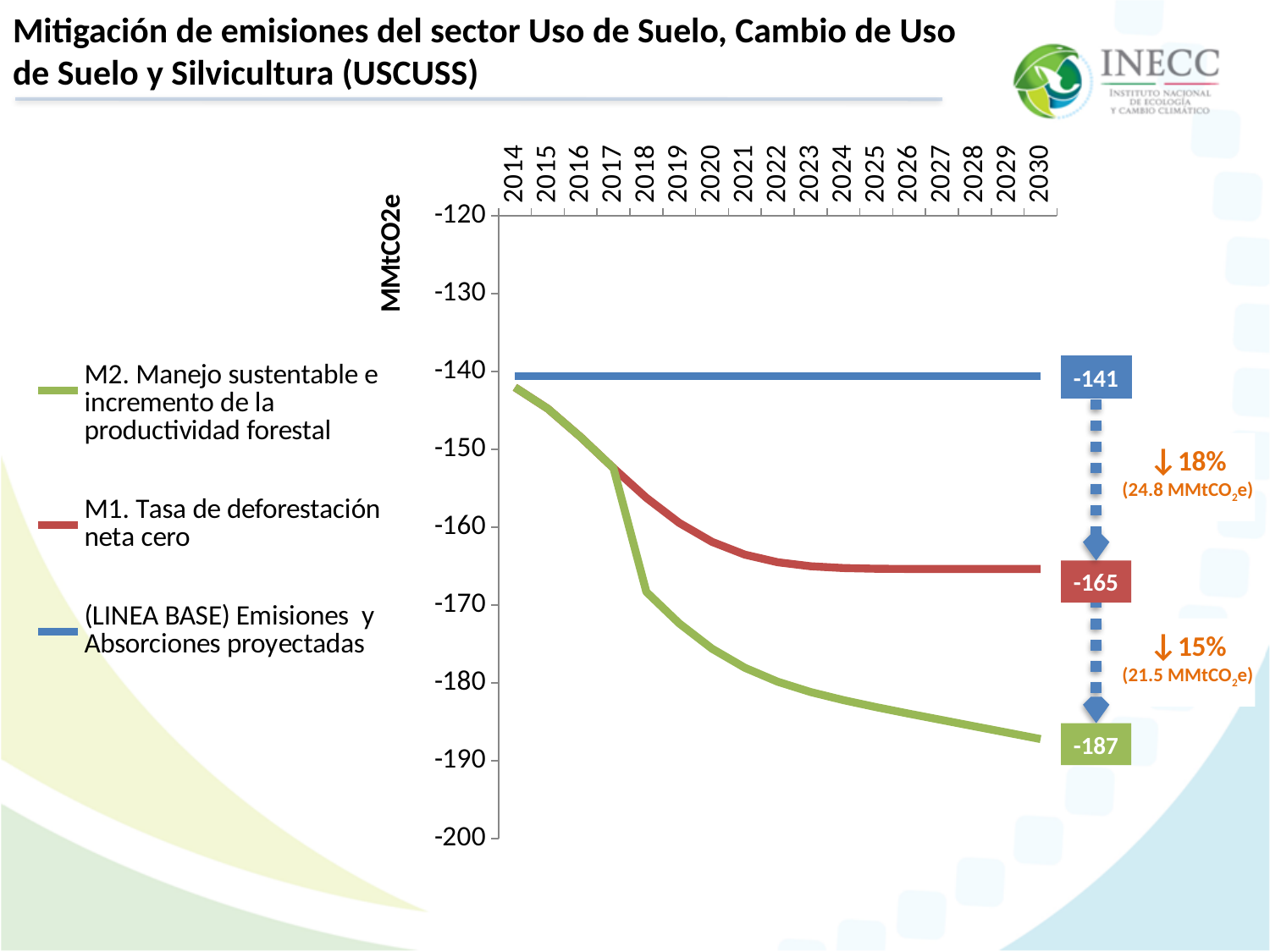
Does the M2 series rise or fall from 2014 to 2030? fall What kind of chart is shown on the slide? line chart How many years are shown on the x axis? 17 What reduction in MMtCO2e is annotated between the M1 and M2 values in 2030? 21.5 MMtCO2e What is the value of the M1. Tasa de deforestación neta cero series in 2030? -165 What is the label on the y axis? MMtCO2e What is the value of the LINEA BASE series in 2030? -141 How many series does the legend list? 3 Which series has the lowest value in 2030? M2. Manejo sustentable e incremento de la productividad forestal What is the value of the M2. Manejo sustentable e incremento de la productividad forestal series in 2030? -187 Is the value of the M2 series in 2020 greater or less than -170? less What percentage reduction is annotated between the LINEA BASE and M1 values in 2030? 18%